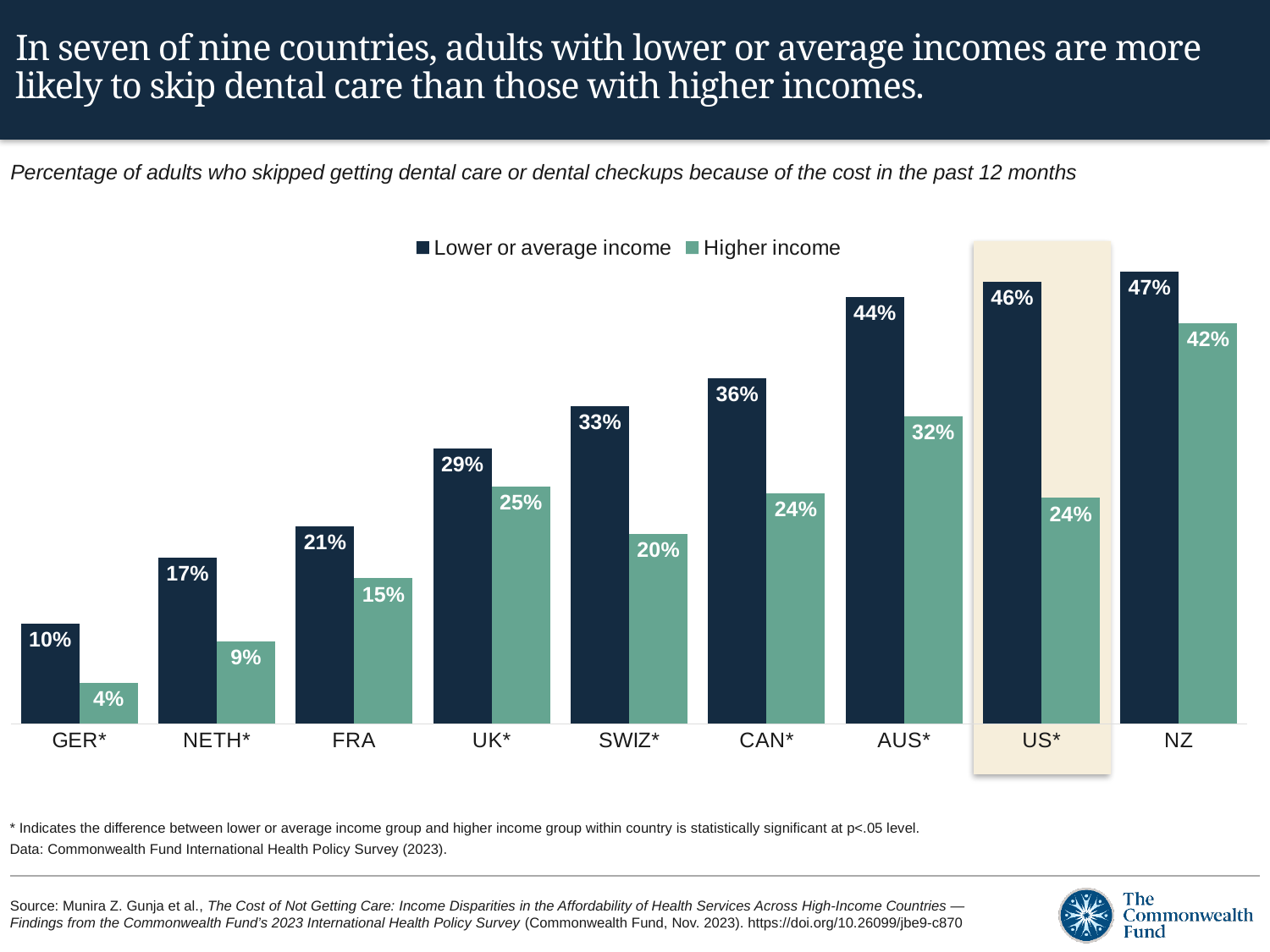
How many series does the legend list? 2 What is the difference between the lower or average income and higher income values for SWIZ*? 13 percentage points What percentage of lower or average income adults in the US* skipped dental care because of cost? 46% Which is larger: the higher income value for UK* or the higher income value for CAN*? UK* Which country has the lowest value for the higher income group? GER* What is the difference between the lower or average income and higher income values for the US*? 22 percentage points How many countries are shown on the x axis? 9 What is the value for higher income adults in GER*? 4% Do the lower or average income values rise or fall from GER* to NZ along the x axis? Rise Which country has the highest value for the lower or average income group? NZ What is the value for higher income adults in AUS*? 32% What kind of chart is shown on the slide? Bar chart